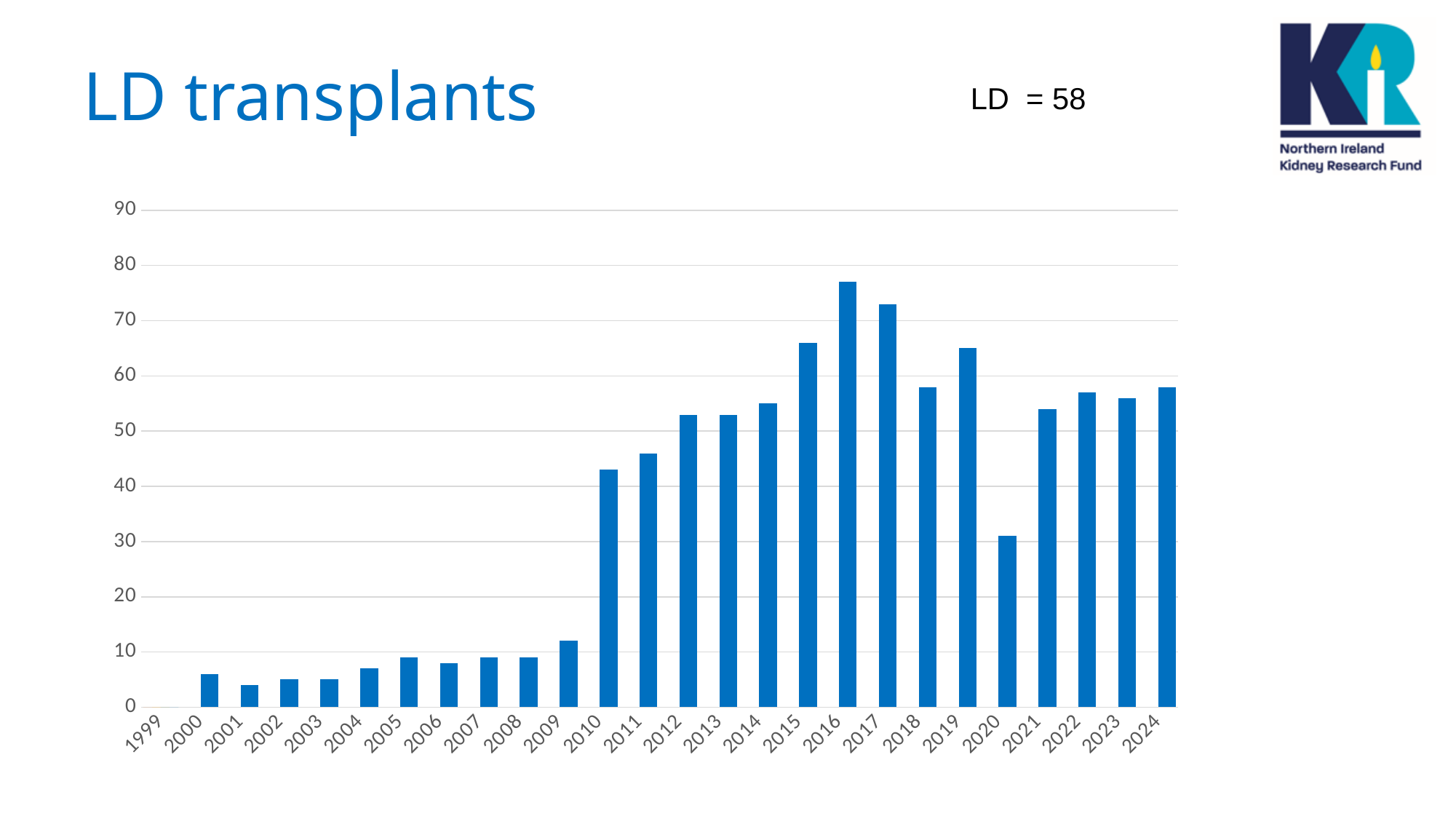
Which year has the larger value, 2018 or 2019? 2019 Is the value for 2016 greater or less than 70? greater What is the title of the chart on the slide? LD transplants How many years are labelled on the x axis of the chart? 26 Is the value for 2009 greater or less than 20? less Is the value for 2000 greater or less than 10? less Which year has the larger value, 2016 or 2020? 2016 Do the values rise or fall from 2010 to 2016? rise Which year has the highest number of LD transplants? 2016 What kind of chart is shown on the slide? bar chart